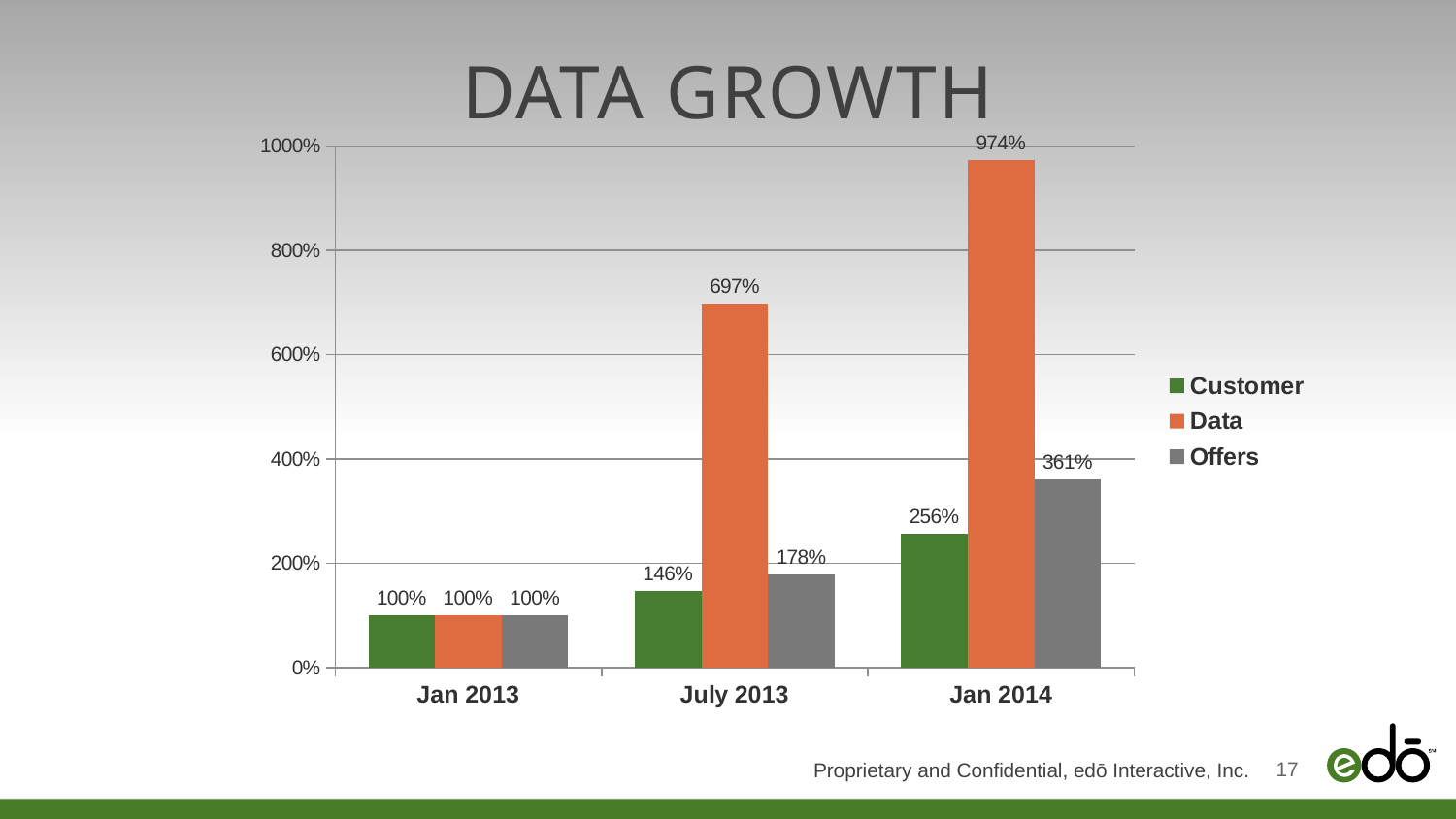
Do the Data values rise or fall from Jan 2013 to Jan 2014? rise Which series has the highest value in July 2013? Data What is the value for Customer in Jan 2014? 256% What is the value for Data in Jan 2014? 974% What kind of chart is shown on the slide? bar chart What is the difference between the Data value and the Offers value in Jan 2014? 613% Which series has the lowest value in Jan 2014? Customer Is the value for Data in July 2013 greater or less than 600%? greater Which is larger: Offers in Jan 2014 or Customer in Jan 2014? Offers in Jan 2014 How many categories are shown on the x axis? 3 How many series does the legend list? 3 What is the value for Offers in July 2013? 178%